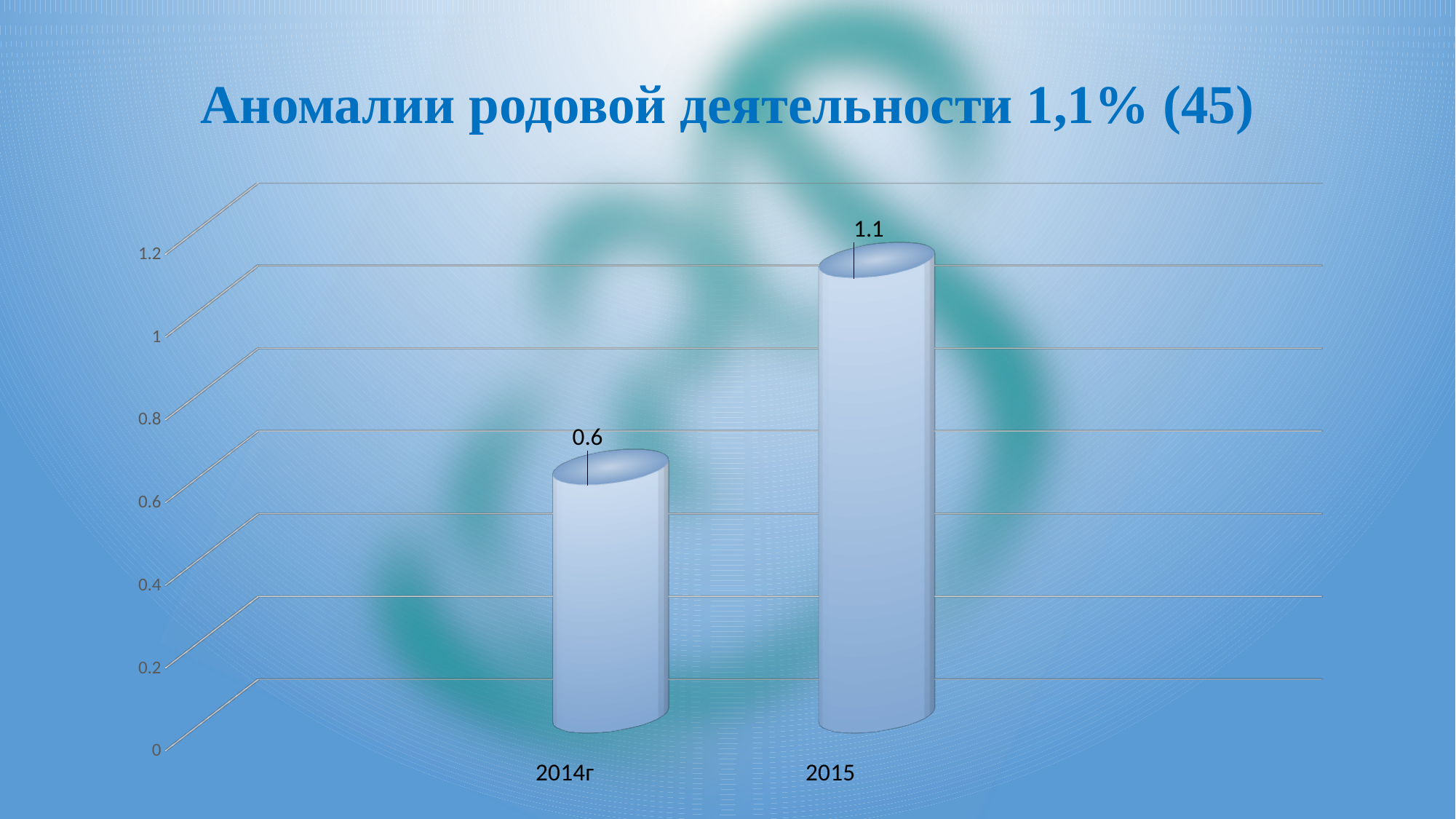
Which is larger, the value for 2014г or the value for 2015? 2015 Is the value for 2015 greater or less than 1? greater What is the difference between the values for 2015 and 2014г? 0.5 Which category has the highest value? 2015 What kind of chart is shown on the slide? bar chart How many categories are shown on the x axis? 2 What is the value for 2015? 1.1 Which category has the lowest value? 2014г Is the value for 2014г greater or less than 0.8? less Do the values rise or fall from 2014г to 2015? rise What is the title of the slide? Аномалии родовой деятельности 1,1% (45) What is the value for 2014г? 0.6